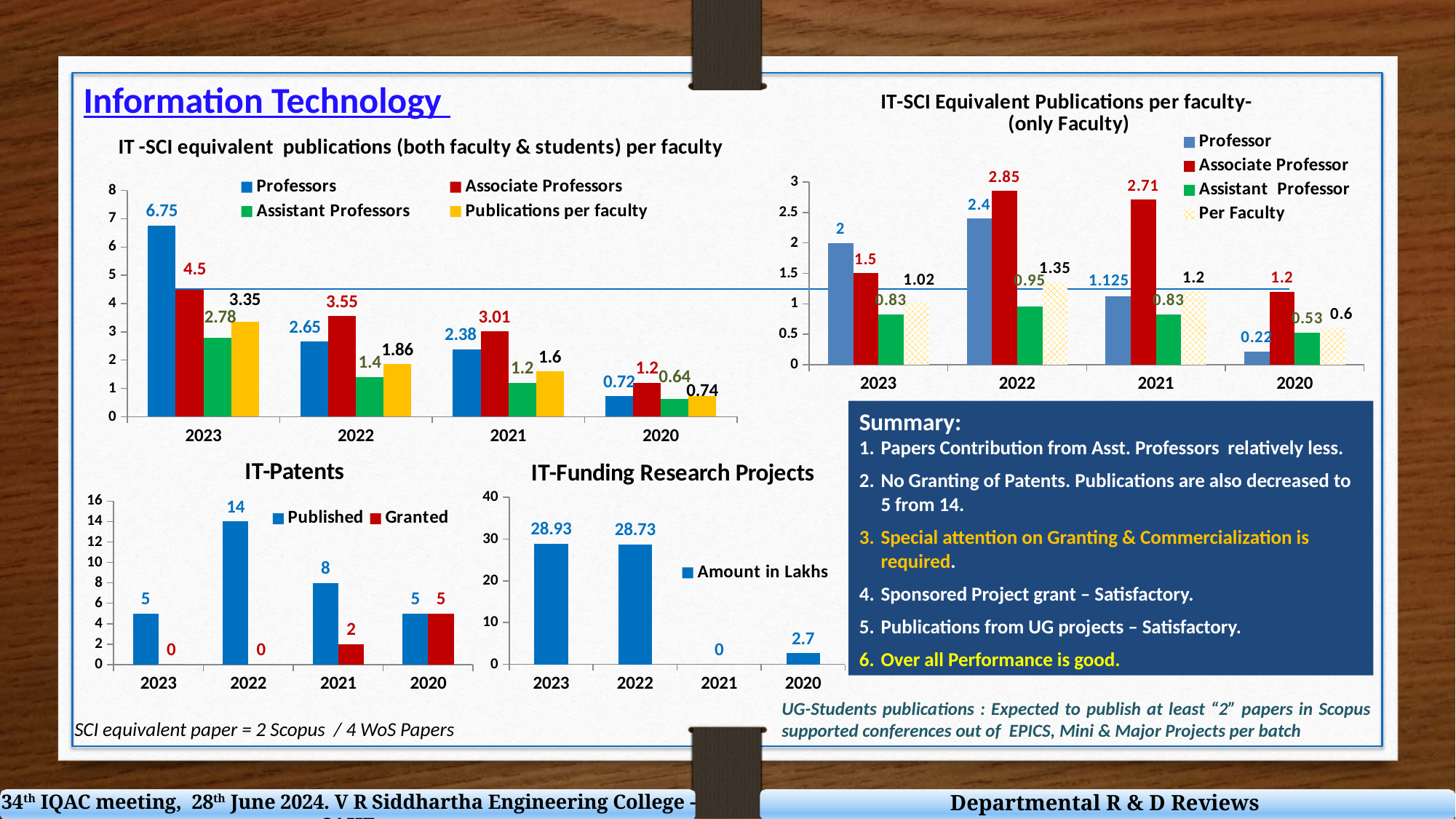
In the 'IT-Patents' chart, how many patents were Granted in 2021? 2 In the 'IT-SCI Equivalent Publications per faculty- (only Faculty)' chart, what is the Per Faculty value for 2020? 0.6 In the 'IT-Patents' chart, which year has the highest number of Published patents? 2022 In the 'IT-SCI Equivalent Publications per faculty- (only Faculty)' chart, which is larger in 2023: the Professor value or the Associate Professor value? Professor In the 'IT-SCI Equivalent Publications per faculty- (only Faculty)' chart, which year has the highest Associate Professor value? 2022 In the 'IT-Funding Research Projects' chart, what is the Amount in Lakhs for 2020? 2.7 In the 'IT-SCI Equivalent Publications per faculty- (only Faculty)' chart, what is the Professor value for 2021? 1.125 What kind of chart is the 'IT-Funding Research Projects' chart? Bar chart In the 'IT -SCI equivalent publications (both faculty & students) per faculty' chart, what is the difference between the Associate Professors value and the Assistant Professors value in 2022? 2.15 In the 'IT-Patents' chart, what is the difference between Published and Granted patents in 2022? 14 In the 'IT -SCI equivalent publications (both faculty & students) per faculty' chart, how many series does the legend list? 4 In the 'IT -SCI equivalent publications (both faculty & students) per faculty' chart, what is the value for Professors in 2023? 6.75